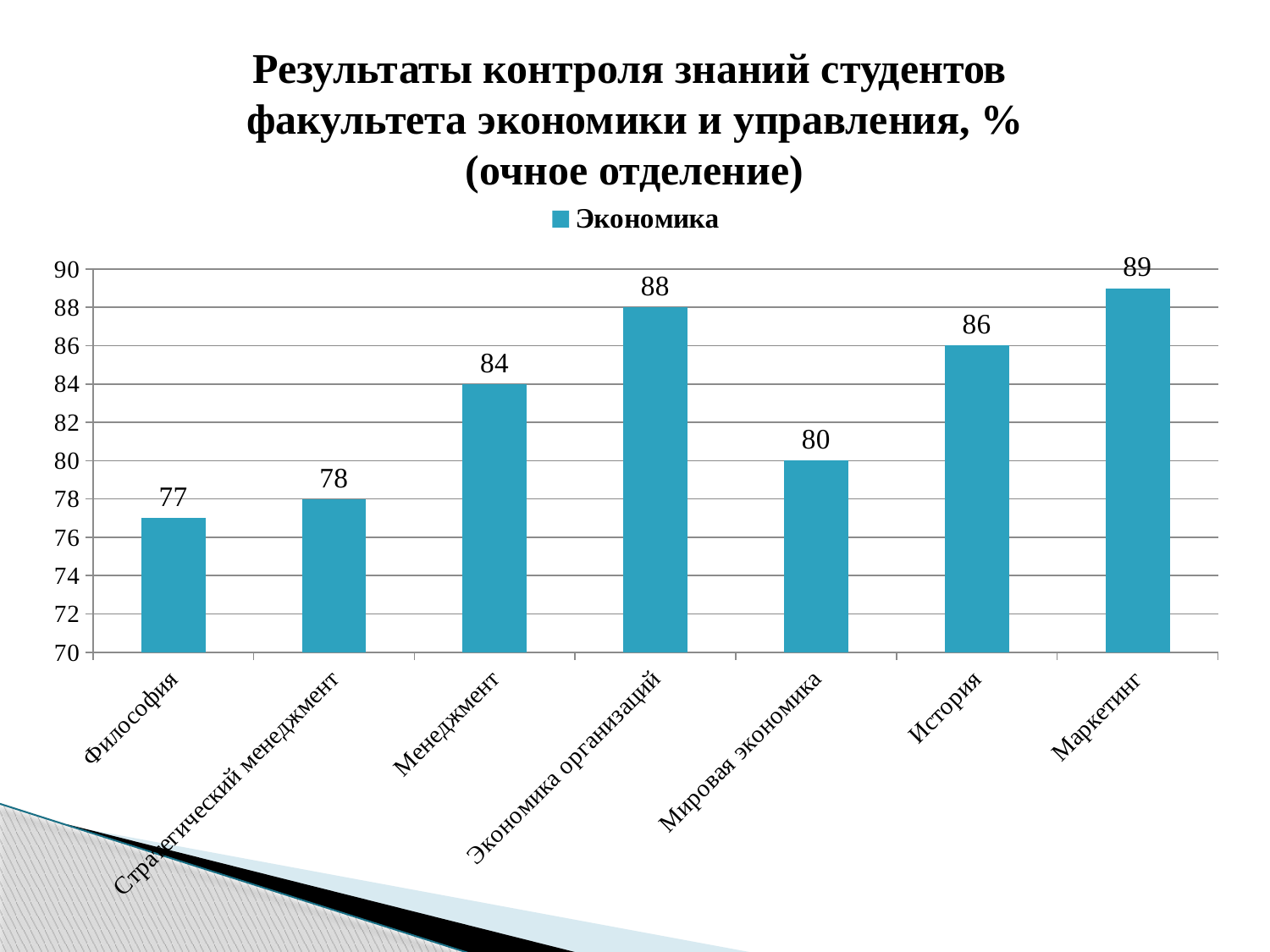
What is the difference between the values for Маркетинг and Философия? 12 What kind of chart is shown on the slide? bar chart What is the value for Философия? 77 How many series does the legend list? 1 How many categories are shown on the x axis? 7 What is the value for Экономика организаций? 88 What is the value for История? 86 Which category has the highest value? Маркетинг Which is larger, the value for Менеджмент or the value for Мировая экономика? Менеджмент What is the difference between the values for Экономика организаций and Мировая экономика? 8 Which category has the lowest value? Философия Is the value for Стратегический менеджмент greater or less than 80? less